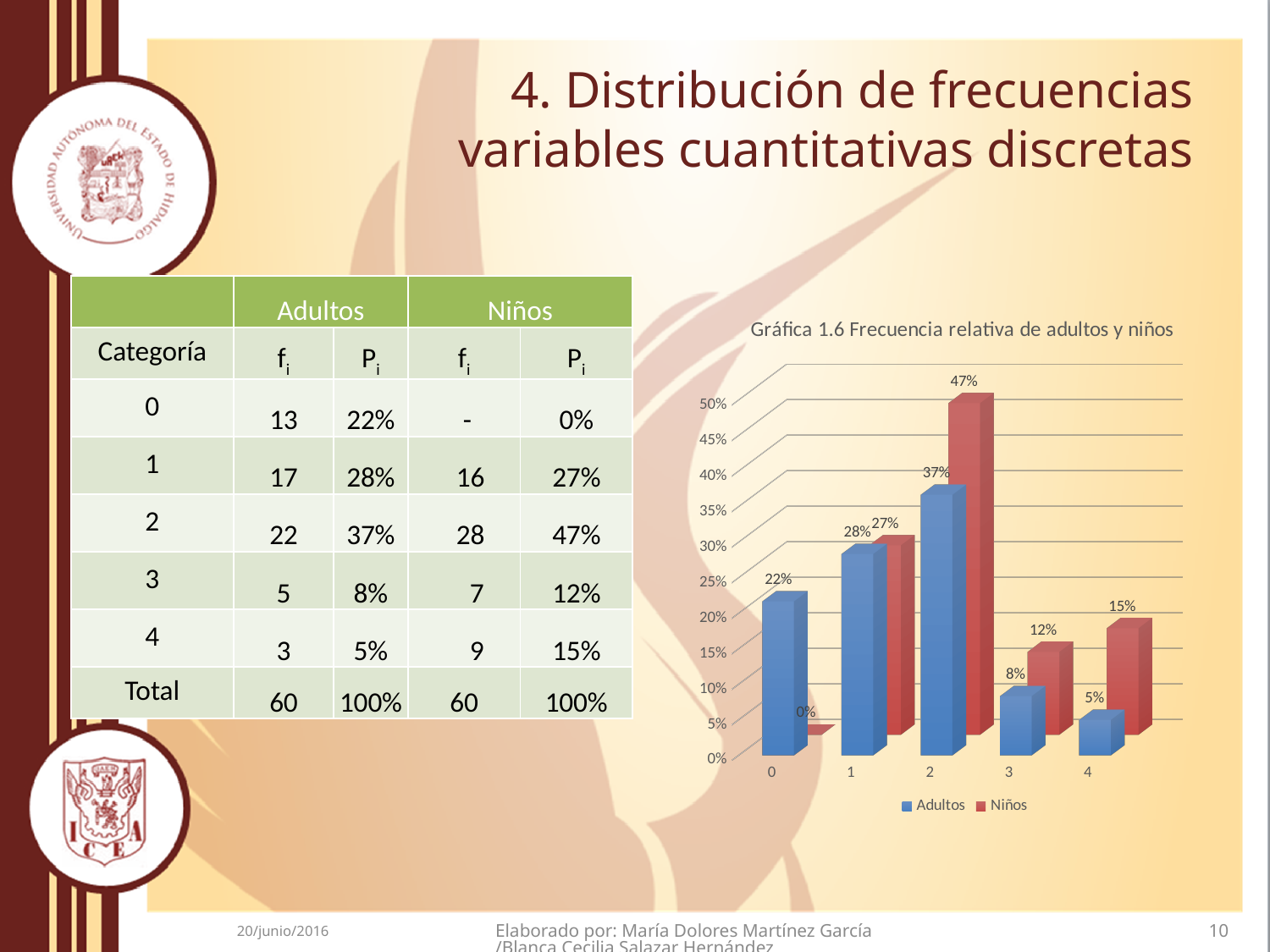
What is the value for Adultos at category 2? 37% Which category has the lowest value for Adultos? 4 What kind of chart is shown on the slide? Bar chart What is the title of the chart? Gráfica 1.6 Frecuencia relativa de adultos y niños Which category has the highest value for Niños? 2 What is the difference between the Niños and Adultos values at category 2? 10% At category 3, which series has the larger value, Adultos or Niños? Niños What is the value for Niños at category 4? 15% How many series does the legend list? 2 How many categories are shown on the x axis? 5 What is the value for Niños at category 0? 0% Which colour represents the Adultos series in the chart? Blue